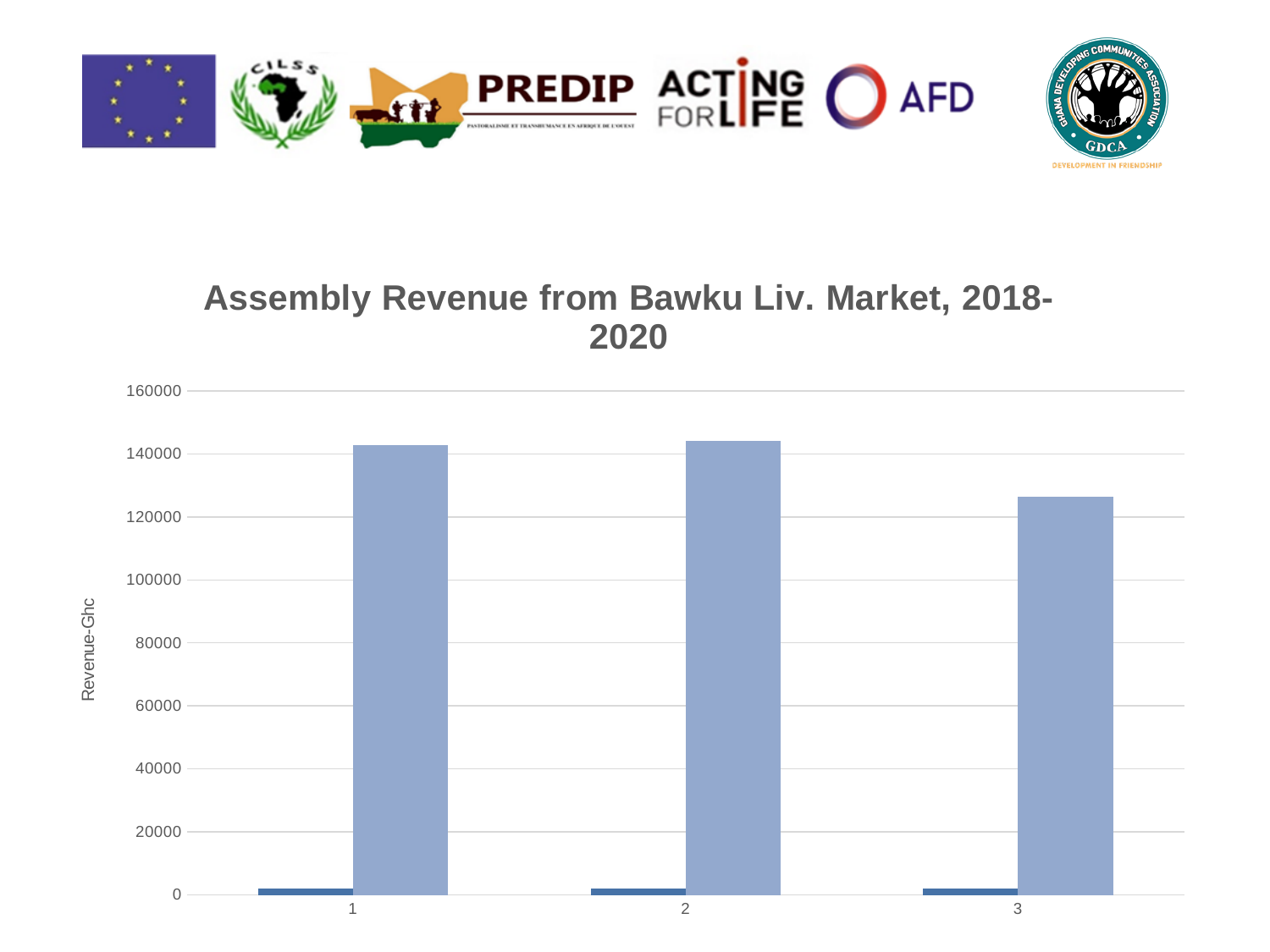
Is the light blue bar for category 1 greater or less than 120000? greater Is the light blue bar for category 3 greater or less than 120000? greater Is the light blue bar for category 3 greater or less than 140000? less Which category has the lowest value for the tall light blue bars? 3 What is the label on the vertical axis of the chart? Revenue-Ghc Which is larger for category 2, the dark blue bar or the light blue bar? the light blue bar What kind of chart is shown on the slide? bar chart Which is larger, the light blue bar for category 1 or the light blue bar for category 3? category 1 How many categories are shown along the x axis? 3 What is the title of the chart? Assembly Revenue from Bawku Liv. Market, 2018-2020